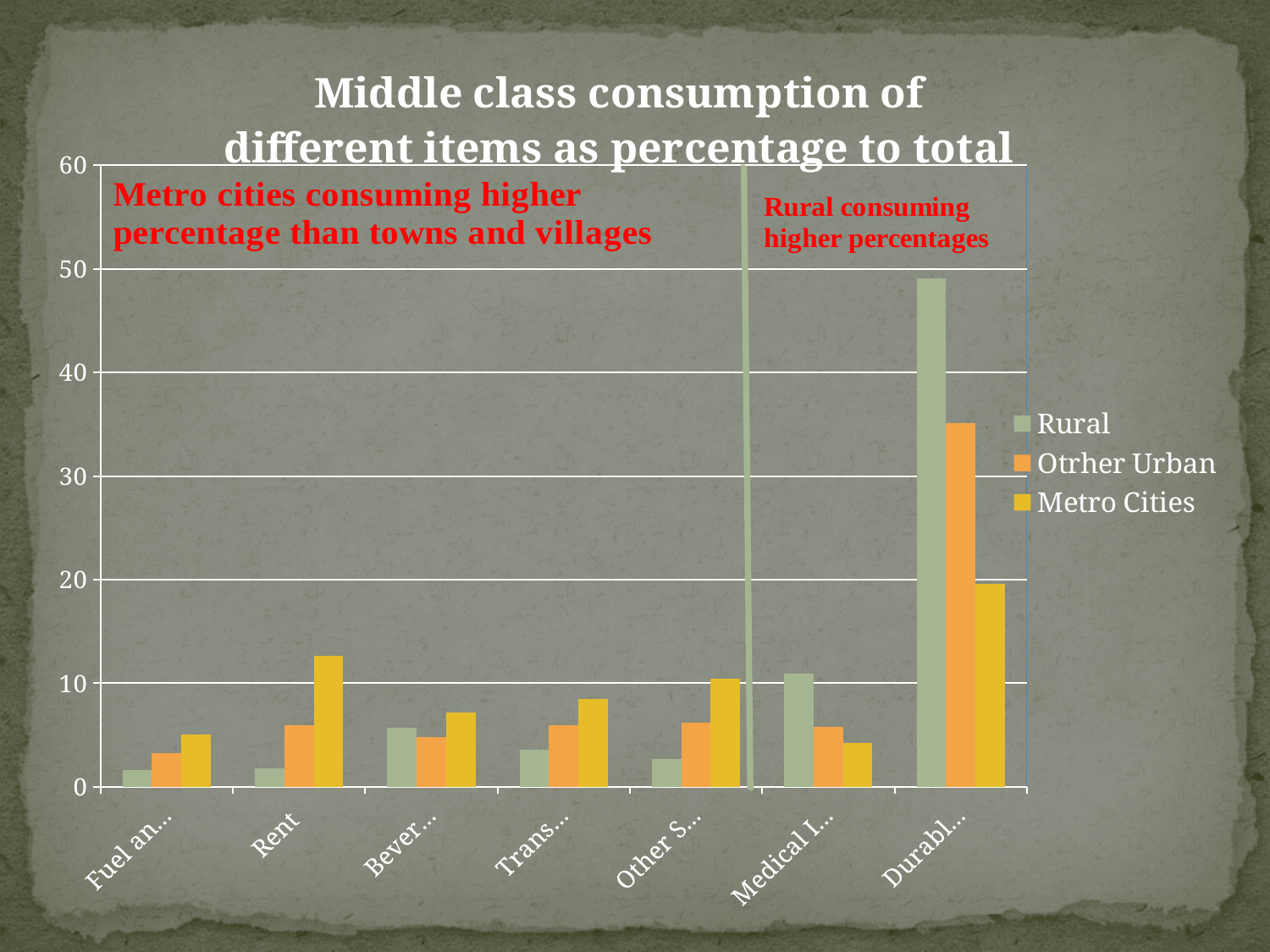
What kind of chart is shown on the slide? bar chart How many series does the legend list? 3 Is the Metro Cities value for Rent greater or less than 10? greater How many categories are shown along the x axis? 7 What is the title of the chart? Middle class consumption of different items as percentage to total Is the Rural value for Rent greater or less than 10? less What are the three series named in the legend? Rural, Otrher Urban, Metro Cities Is the Otrher Urban value for the category labelled "Durabl..." greater or less than 30? greater Which category has the highest Rural value? Durabl... For the category labelled "Durabl...", which series has the larger value: Rural or Metro Cities? Rural For Rent, which series has the larger value: Rural or Metro Cities? Metro Cities